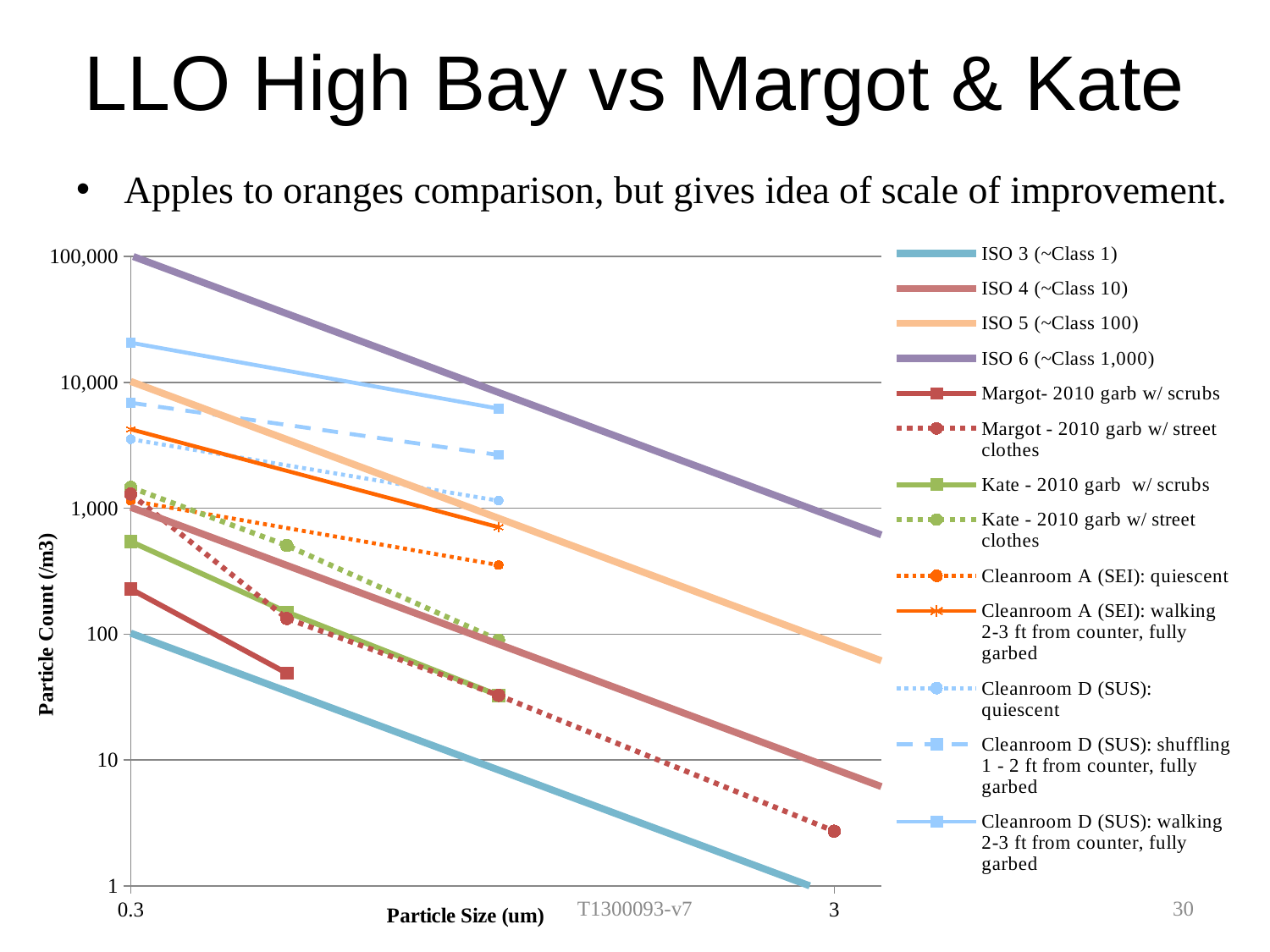
Is the value for 'Cleanroom D (SUS): walking 2-3 ft from counter, fully garbed' at 0.3 um greater or less than 10,000? greater What kind of chart is shown on the slide? line chart Is the value for 'Kate - 2010 garb w/ scrubs' at 0.3 um greater or less than 1,000? less Is the value for 'Cleanroom A (SEI): walking 2-3 ft from counter, fully garbed' at 0.3 um greater or less than 1,000? greater At 0.3 um, which is larger: the value for 'Kate - 2010 garb w/ scrubs' or 'Margot- 2010 garb w/ scrubs'? Kate - 2010 garb w/ scrubs Which series has the highest particle count at 0.3 um? ISO 6 (~Class 1,000) What is the title of the chart's y axis? Particle Count (/m3) What is the title of the chart's x axis? Particle Size (um) Which series has the lowest particle count at 0.3 um? ISO 3 (~Class 1) How many series does the chart legend list? 13 Do the plotted particle counts rise or fall as particle size increases along the x axis? fall